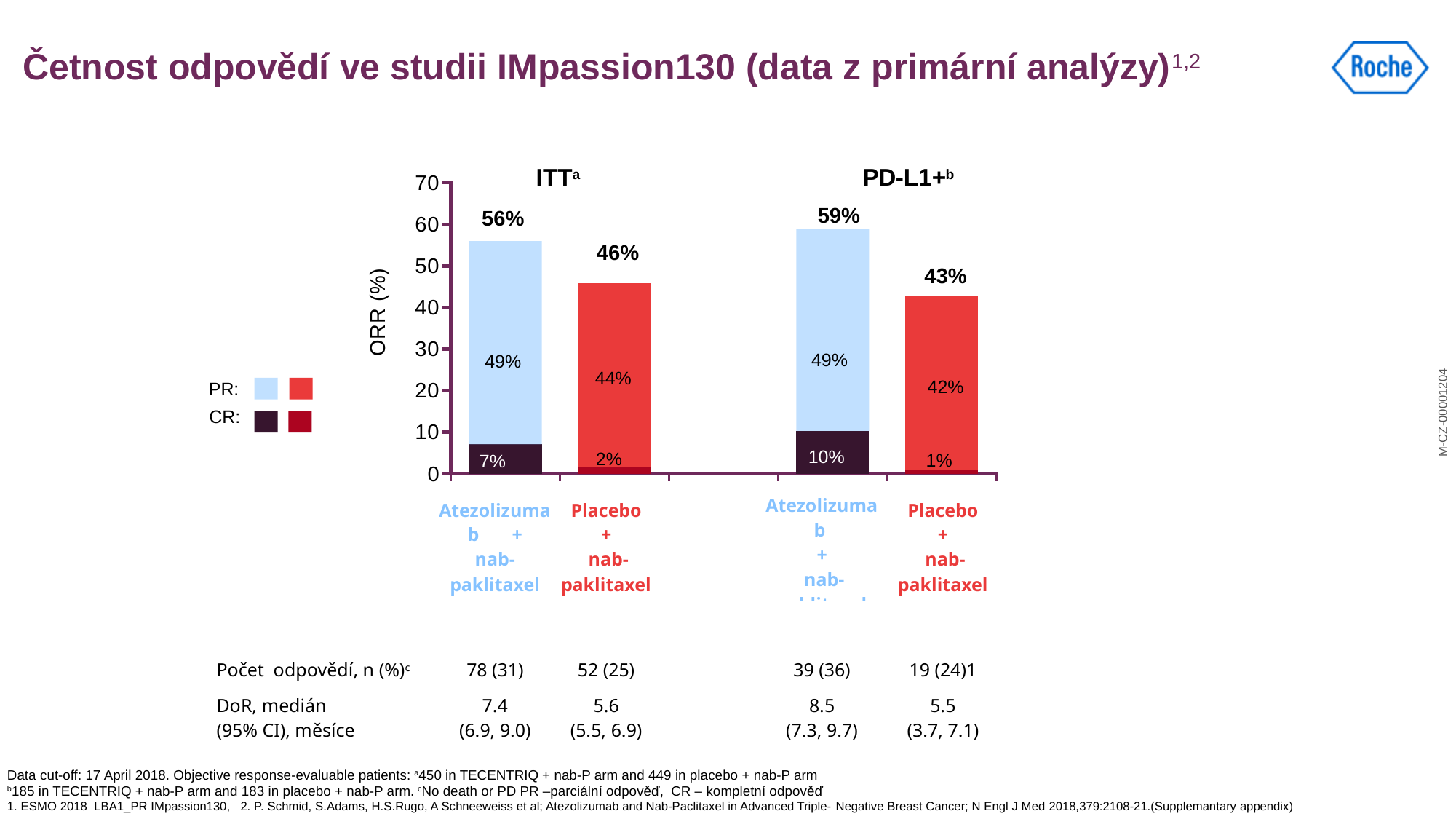
What is the difference in total ORR between Atezolizumab + nab-paklitaxel and Placebo + nab-paklitaxel in the PD-L1+ population? 16% What is the PR percentage for Placebo + nab-paklitaxel in the ITT population? 44% Which bar has the highest total ORR? Atezolizumab + nab-paklitaxel (PD-L1+) What is the label of the y axis of the chart? ORR (%) What is the difference in total ORR between Atezolizumab + nab-paklitaxel and Placebo + nab-paklitaxel in the ITT population? 10% Which bar has the lowest total ORR? Placebo + nab-paklitaxel (PD-L1+) What type of chart is shown on the slide? Stacked bar chart What is the total ORR for Atezolizumab + nab-paklitaxel in the ITT population? 56% How many bars are plotted in the chart? 4 What is the total ORR for Placebo + nab-paklitaxel in the PD-L1+ population? 43% What is the CR percentage for Atezolizumab + nab-paklitaxel in the PD-L1+ population? 10% Which has a higher CR percentage in the ITT population: Atezolizumab + nab-paklitaxel or Placebo + nab-paklitaxel? Atezolizumab + nab-paklitaxel